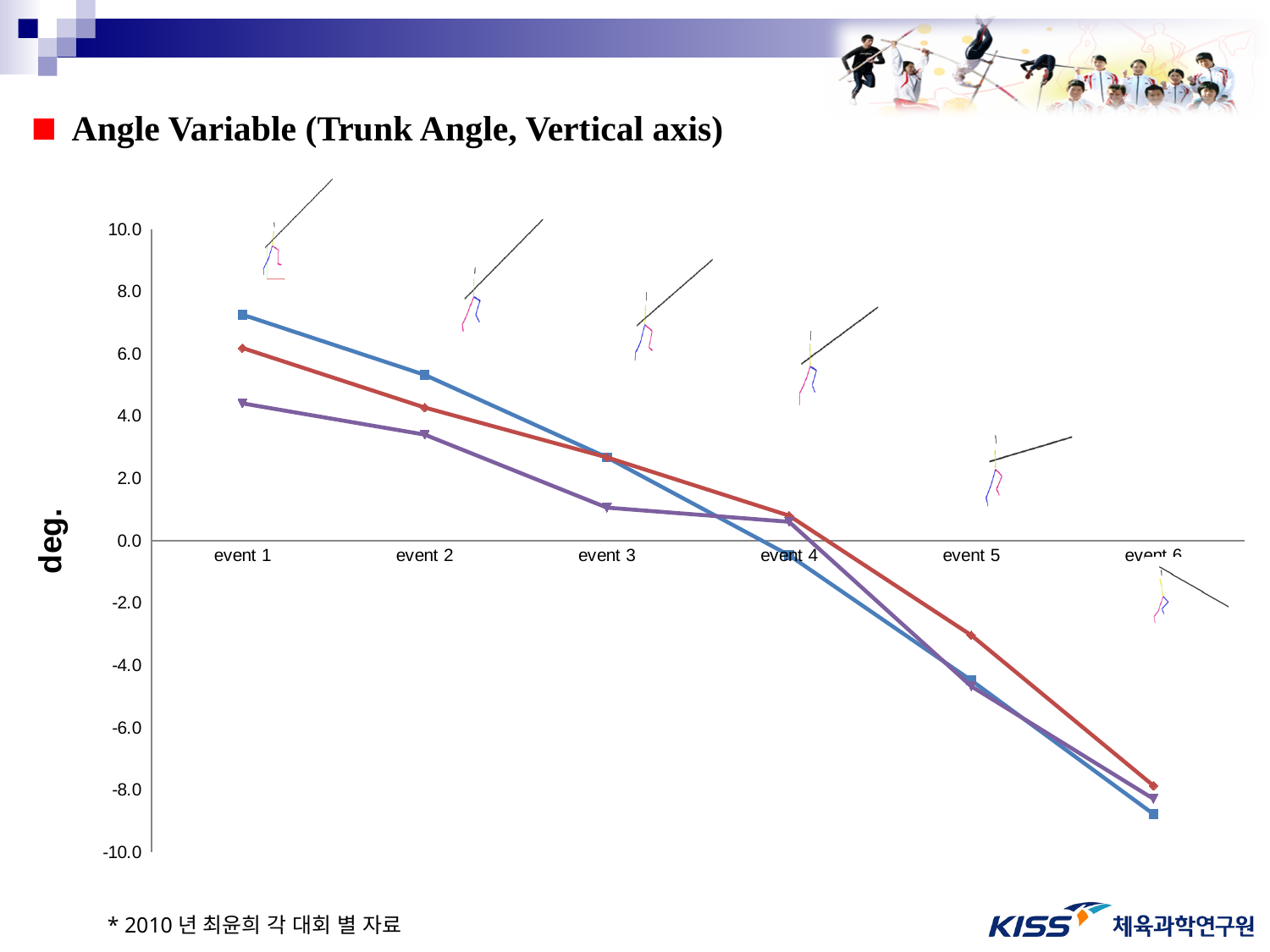
Is the value of the purple line at event 1 greater or less than 6.0? less Is the value of the red line at event 5 greater or less than -4.0? greater At event 1, which line has the larger value, the blue line or the purple line? the blue line How many lines are plotted on the chart? 3 What is the label on the vertical axis of the chart? deg. Do the values of the lines rise or fall from event 1 to event 6? fall Is the value of the blue line at event 1 greater or less than 6.0? greater What kind of chart is shown on the slide? line chart How many events are shown along the x axis of the chart? 6 At which event does the blue line reach its highest value? event 1 At which event does the red line reach its lowest value? event 6